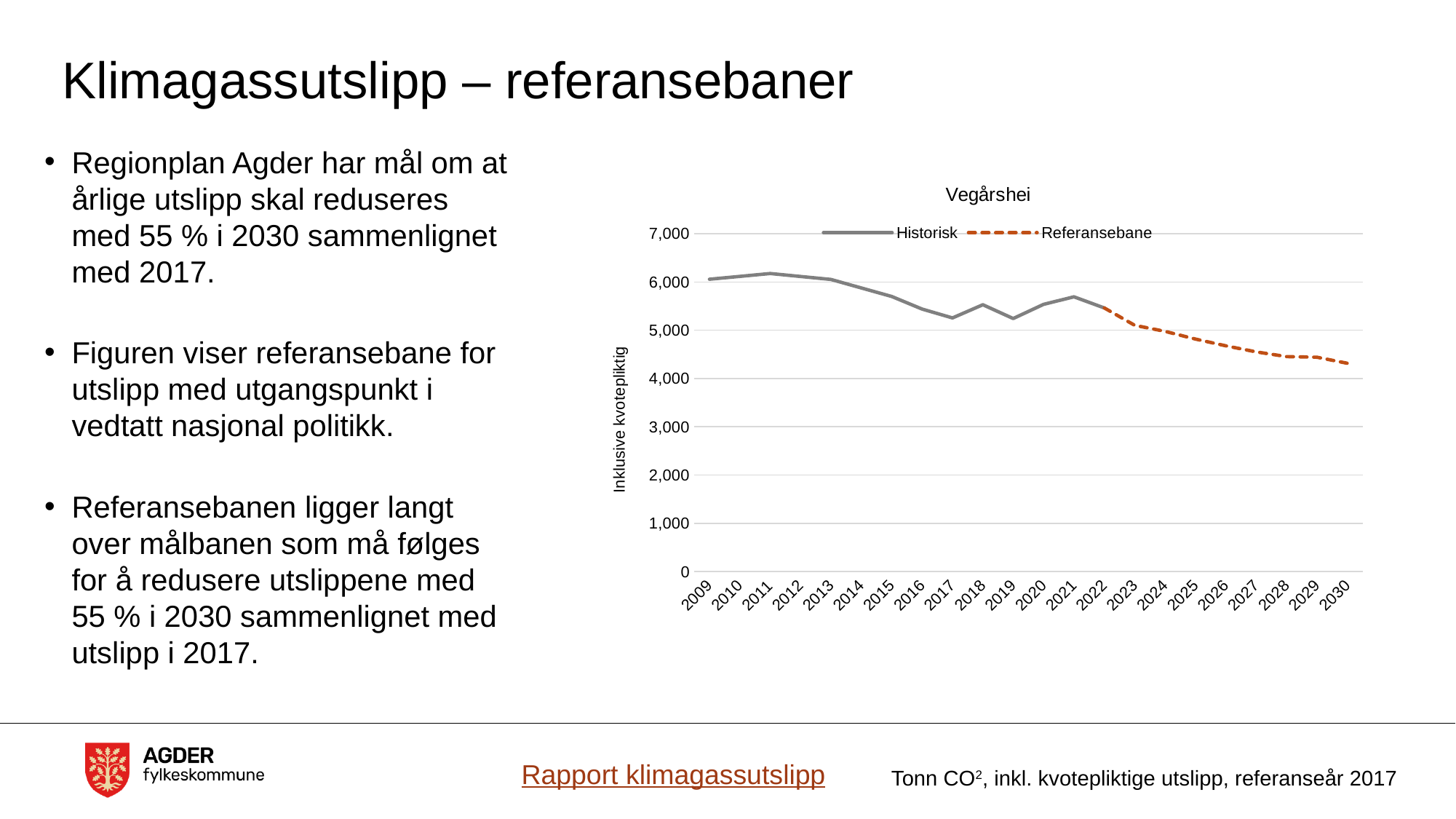
Is the Referansebane value for 2030 greater or less than 5,000? less Is the Historisk value for 2021 greater or less than 6,000? less Is the Referansebane value for 2030 greater or less than 4,000? greater How many series does the chart legend list? 2 Does the Historisk series rise or fall overall from 2011 to 2017? fall What are the two series named in the chart legend? Historisk and Referansebane How many years are shown along the x axis of the chart? 22 What kind of chart is shown on the slide? line chart What is the title of the chart? Vegårshei Does the Referansebane series rise or fall from 2022 to 2030? fall